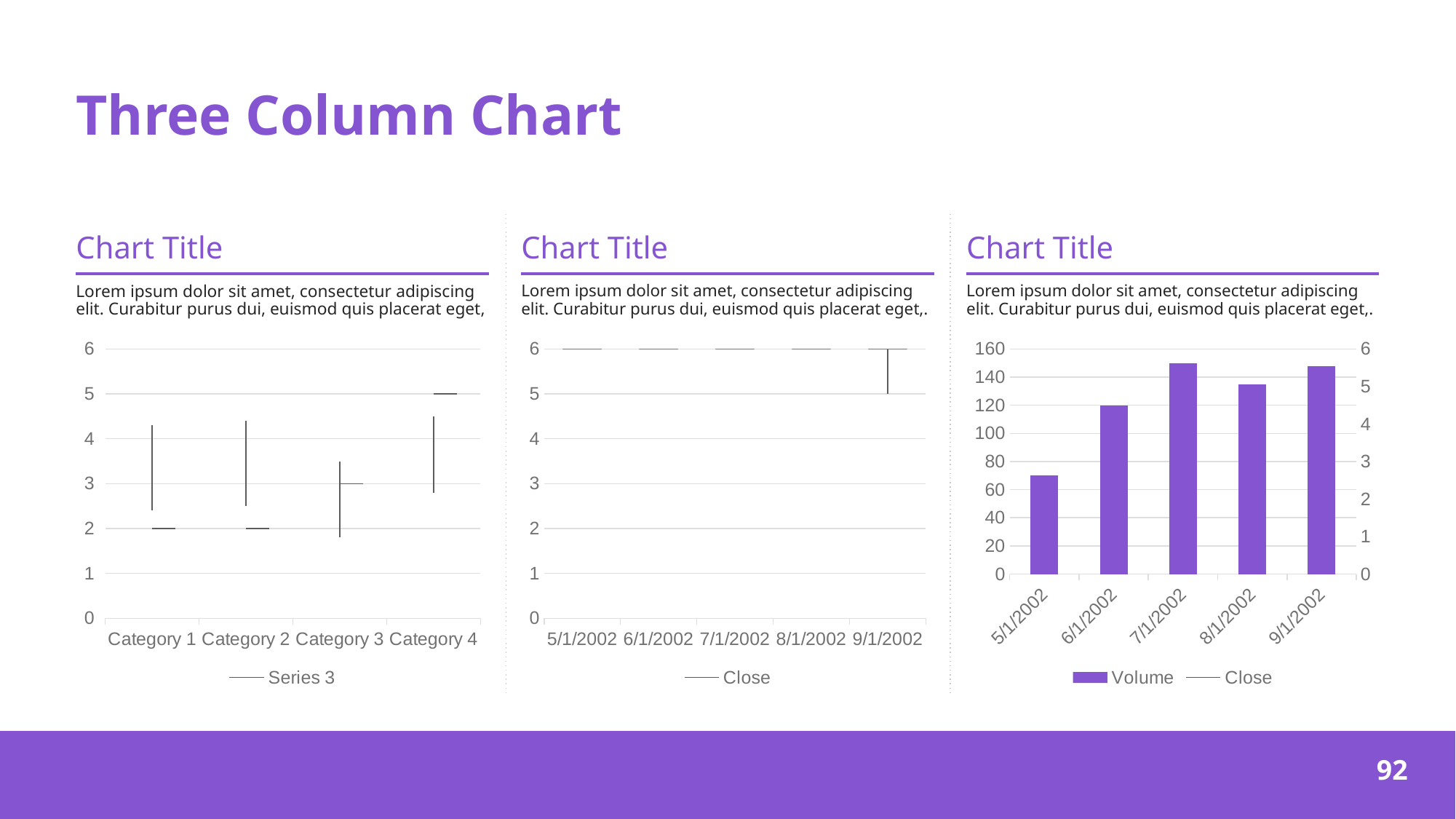
On the right chart, how many series does the legend list? 2 On the right chart, is the Volume for 7/1/2002 greater or less than 140? greater What kind of chart is the right chart? bar chart On the middle chart, what is the name of the series in the legend? Close On the left chart, what is the name of the series in the legend? Series 3 On the right chart, is the Volume for 5/1/2002 greater or less than 80? less On the right chart, is the Volume for 8/1/2002 greater or less than 120? greater On the right chart, what is the Volume value for 6/1/2002? 120 On the left chart, how many categories are shown on the x axis? 4 On the right chart, how many dates are shown on the x axis? 5 On the right chart, which date has the lowest Volume bar? 5/1/2002 On the right chart, which has the larger Volume bar, 6/1/2002 or 8/1/2002? 8/1/2002